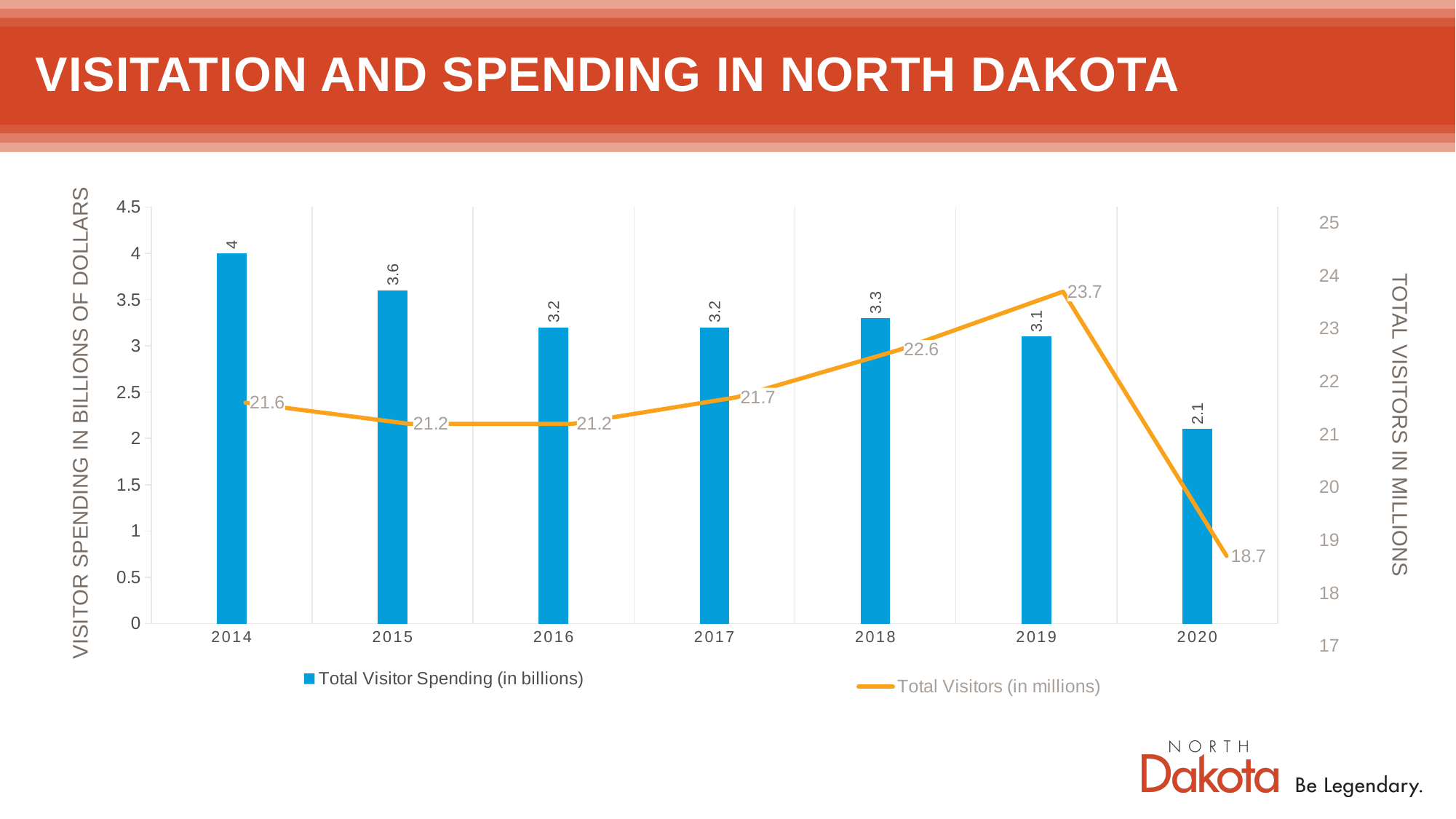
What was Total Visitor Spending (in billions) in 2020? 2.1 How many years are shown on the x axis? 7 Which year had more Total Visitors (in millions), 2018 or 2017? 2018 What was Total Visitor Spending (in billions) in 2014? 4 What is the difference in Total Visitor Spending (in billions) between 2014 and 2015? 0.4 What is the difference in Total Visitors (in millions) between 2019 and 2020? 5 How many series does the legend list? 2 What is the title of the slide? VISITATION AND SPENDING IN NORTH DAKOTA Which year had the lowest Total Visitor Spending (in billions)? 2020 Which year had the highest Total Visitors (in millions)? 2019 What was the Total Visitors (in millions) value in 2019? 23.7 Did Total Visitor Spending (in billions) rise or fall from 2019 to 2020? fall